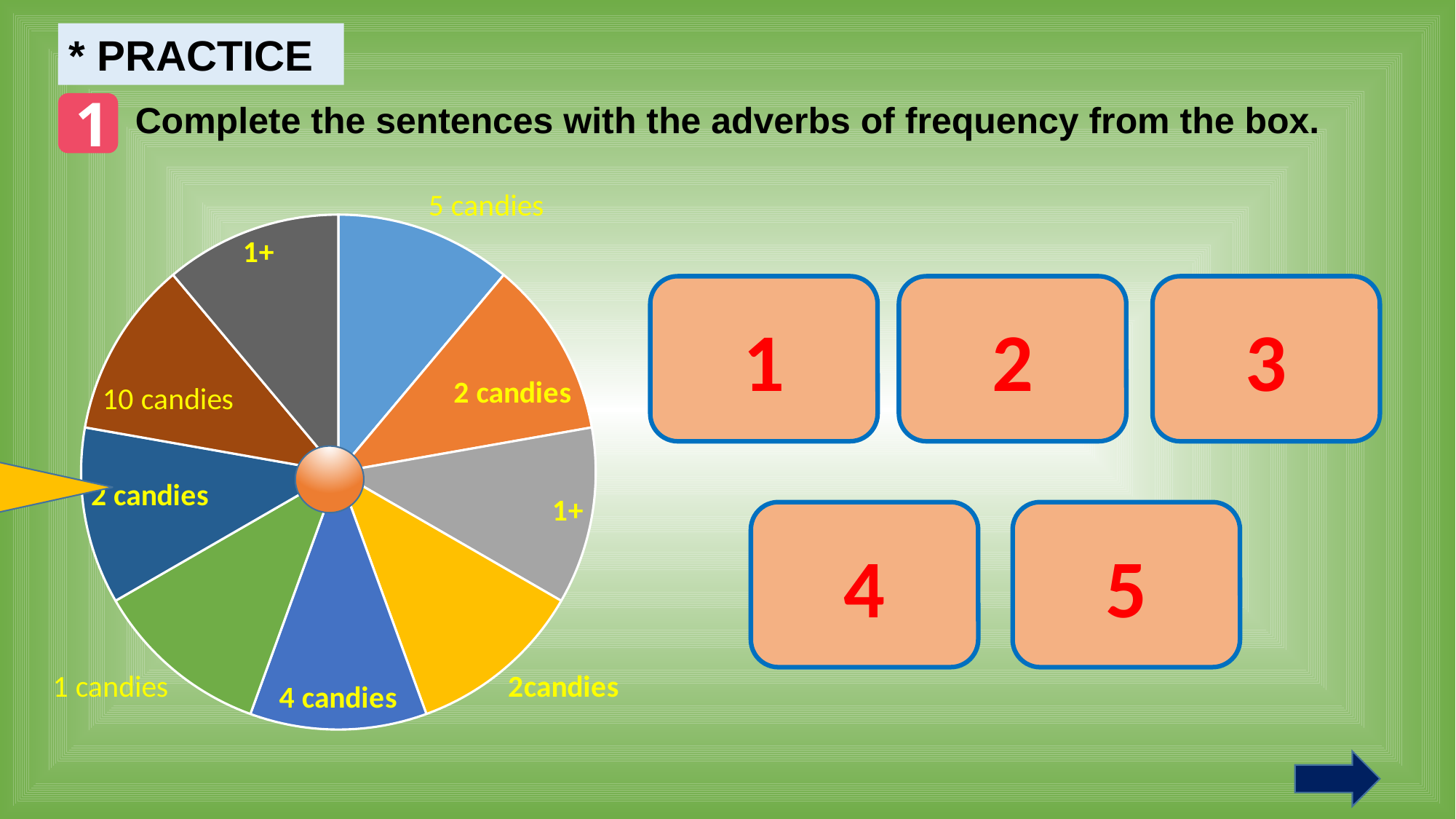
How many numbered boxes are shown to the right of the wheel? 5 How many slices does the wheel on the left of the slide have? 9 What kind of chart is the spinning wheel on the left of the slide? pie chart How many slices of the wheel are labelled "1+"? 2 What label is written on the light blue slice at the top of the wheel? 5 candies What label is written on the royal blue slice at the bottom of the wheel? 4 candies What label is written on the brown slice of the wheel? 10 candies What label is written on the green slice of the wheel? 1 candies Are the slices of the wheel all the same size? yes Which slice label on the wheel shows the largest number of candies? 10 candies